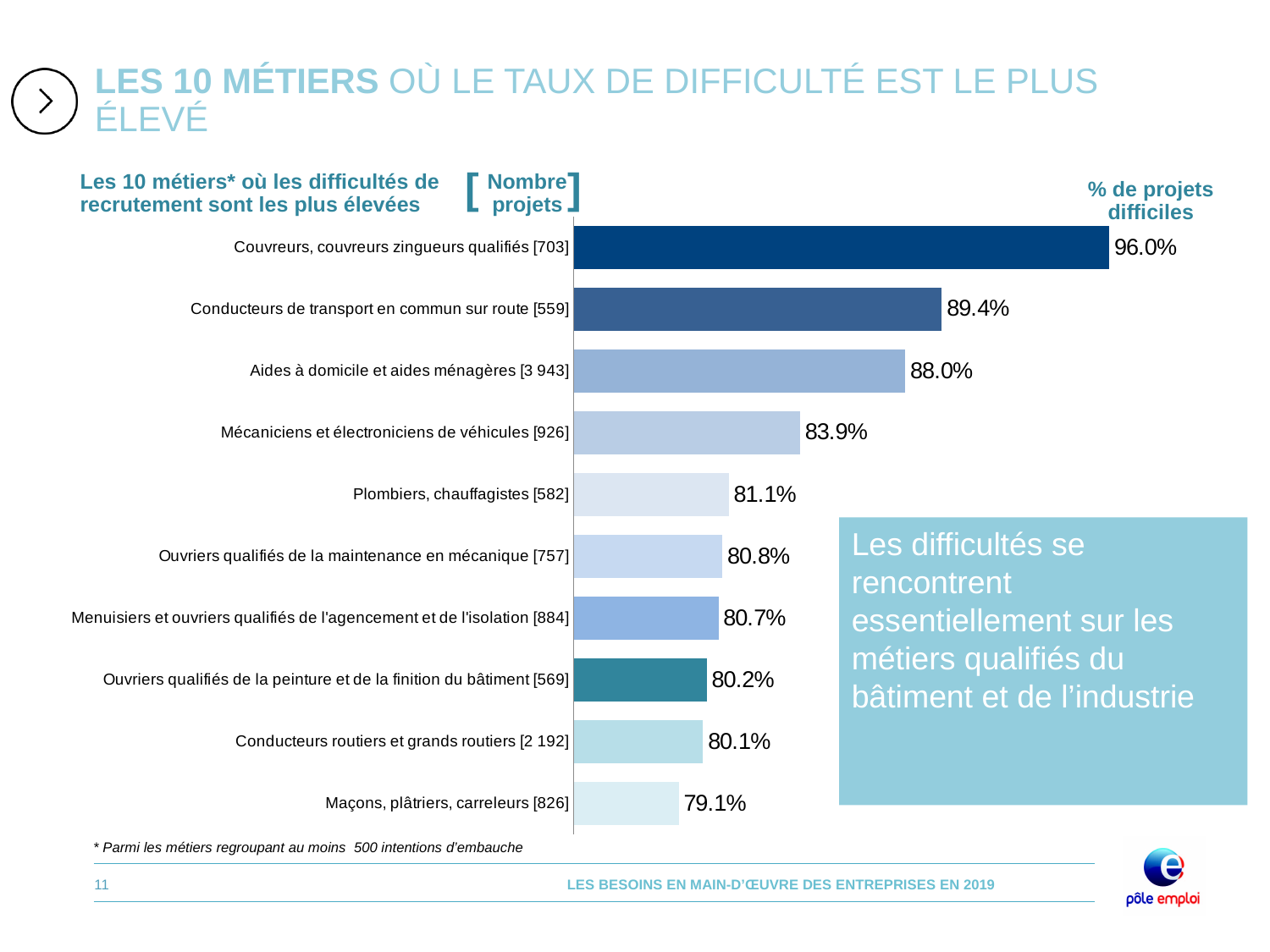
Which category has the lowest value? Maçons, plâtriers, carreleurs Which category has the highest value? Couvreurs, couvreurs zingueurs qualifiés What is the value for Couvreurs, couvreurs zingueurs qualifiés? 96.0% How many projects (nombre de projets) are shown in brackets for Aides à domicile et aides ménagères? 3 943 What is the label of the column header on the right side of the chart? % de projets difficiles Which is larger: the value for Plombiers, chauffagistes or the value for Mécaniciens et électroniciens de véhicules? Mécaniciens et électroniciens de véhicules What is the difference between the values for Couvreurs, couvreurs zingueurs qualifiés and Maçons, plâtriers, carreleurs? 16.9% What is the difference between the values for Conducteurs de transport en commun sur route and Mécaniciens et électroniciens de véhicules? 5.5% What is the value for Aides à domicile et aides ménagères? 88.0% What is the value for Conducteurs routiers et grands routiers? 80.1% What kind of chart is shown on the slide? Bar chart How many categories are shown in the chart? 10